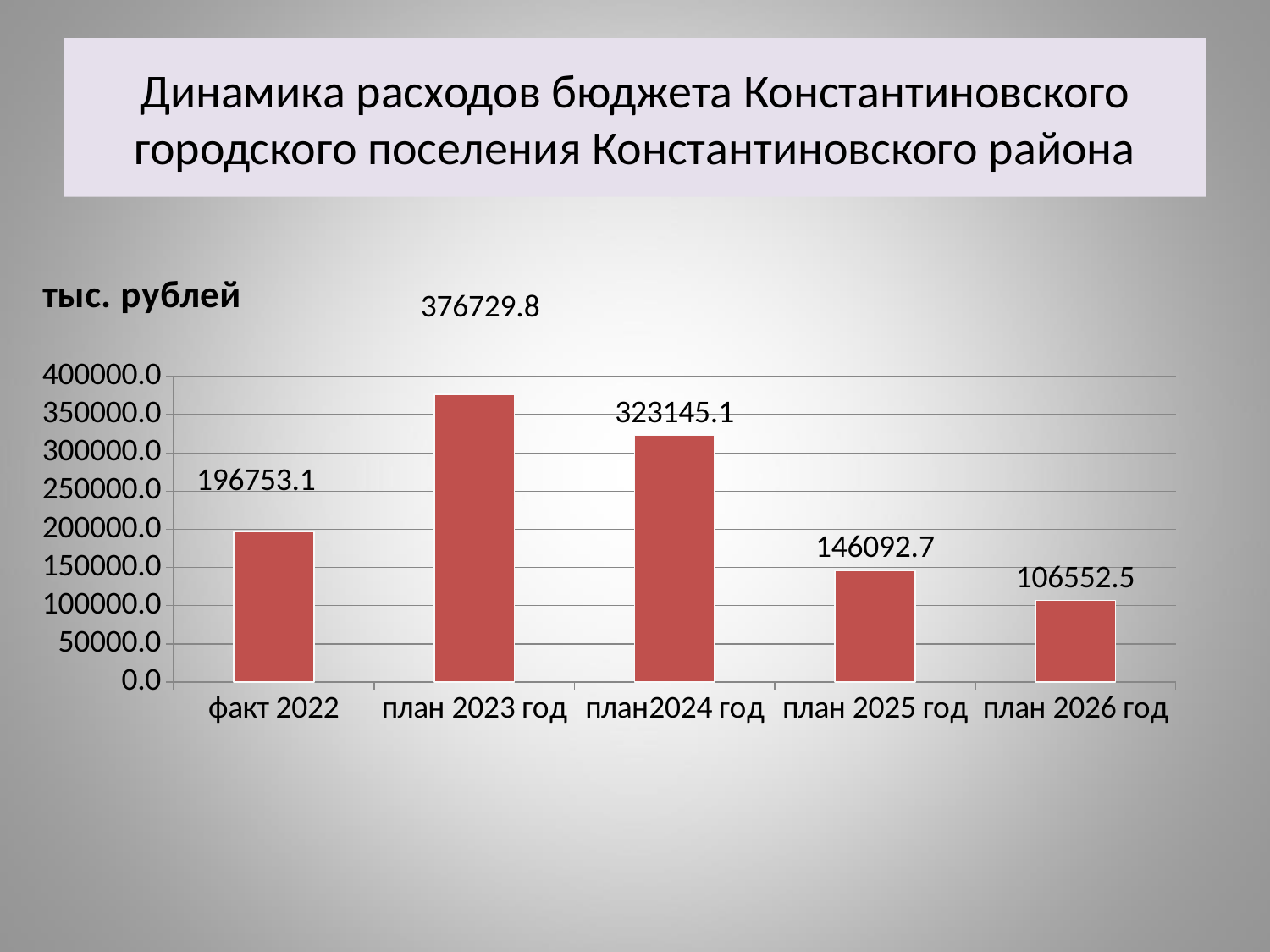
What is the value for план 2023 год? 376729.8 Which is larger, the value for факт 2022 or the value for план 2025 год? факт 2022 What unit is indicated for the values on the chart? тыс. рублей What is the difference between the values for план 2023 год and план2024 год? 53584.7 What is the difference between the values for план 2025 год and план 2026 год? 39540.2 How many categories are shown on the x axis? 5 Which category has the lowest value? план 2026 год What is the value for план 2025 год? 146092.7 What kind of chart is shown on the slide? bar chart What is the value for план 2026 год? 106552.5 Which category has the highest value? план 2023 год What is the value for факт 2022? 196753.1